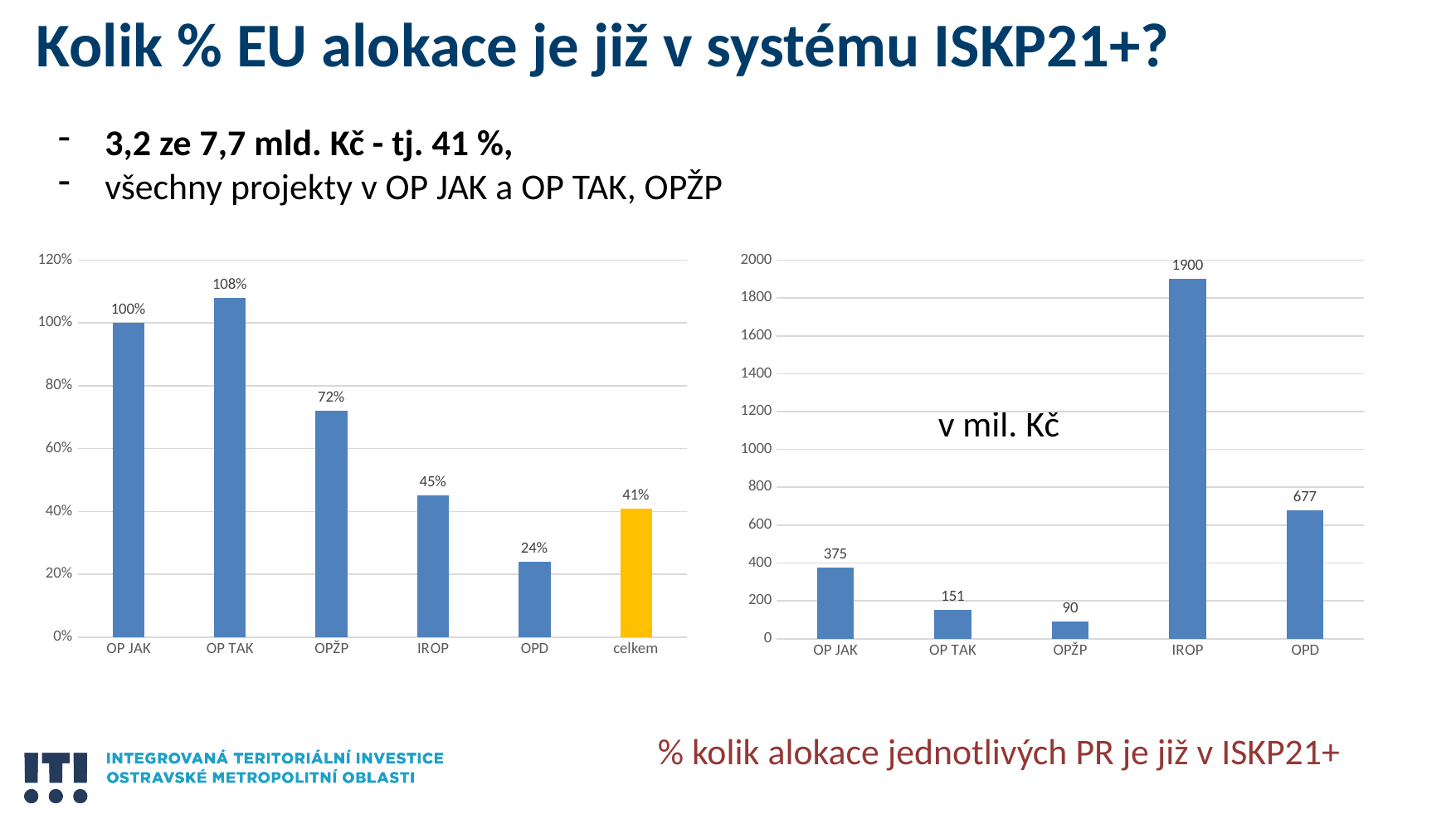
In the left chart (percentages), which bar is coloured differently (yellow) from the others? celkem In the left chart (percentages), what is the value for IROP? 45% In the right chart (v mil. Kč), what is the difference between OPD and OP JAK? 302 In the left chart (percentages), what is the difference between OP JAK and OPŽP? 28% In the left chart (percentages), which category has the lowest value? OPD What kind of chart is the right chart (v mil. Kč)? bar chart In the right chart (v mil. Kč), what is the value for IROP? 1900 In the left chart (percentages), which category has the highest value? OP TAK In the left chart (percentages), how many bars are there? 6 In the left chart (percentages), what is the value for OP TAK? 108% In the right chart (v mil. Kč), what is the value for OPŽP? 90 In the right chart (v mil. Kč), which category has the highest value? IROP